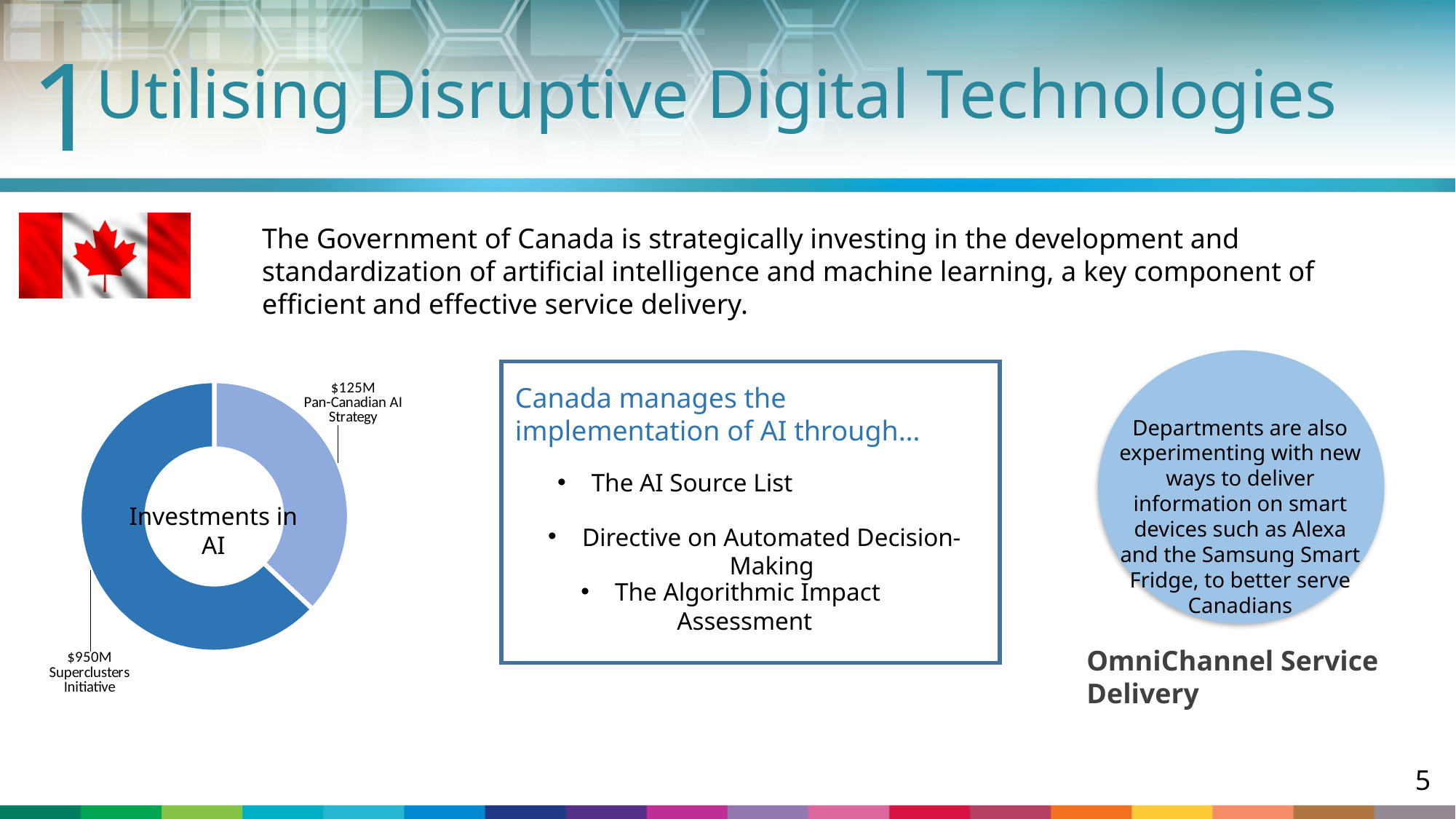
Which category in the Investments in AI chart is drawn in the darker blue? Superclusters Initiative How many categories are shown in the Investments in AI chart? 2 What is the combined total of the two values labelled in the Investments in AI chart? $1,075M Which category in the Investments in AI chart has the largest value? Superclusters Initiative In the Investments in AI chart, how much larger is the Superclusters Initiative value than the Pan-Canadian AI Strategy value? $825M What is the value shown for the Superclusters Initiative in the Investments in AI chart? $950M In the Investments in AI chart, which is larger: the Pan-Canadian AI Strategy or the Superclusters Initiative? Superclusters Initiative Which category in the Investments in AI chart has the smallest value? Pan-Canadian AI Strategy What is the title shown in the centre of the doughnut chart? Investments in AI What kind of chart is the Investments in AI chart? Doughnut chart What is the value shown for the Pan-Canadian AI Strategy in the Investments in AI chart? $125M